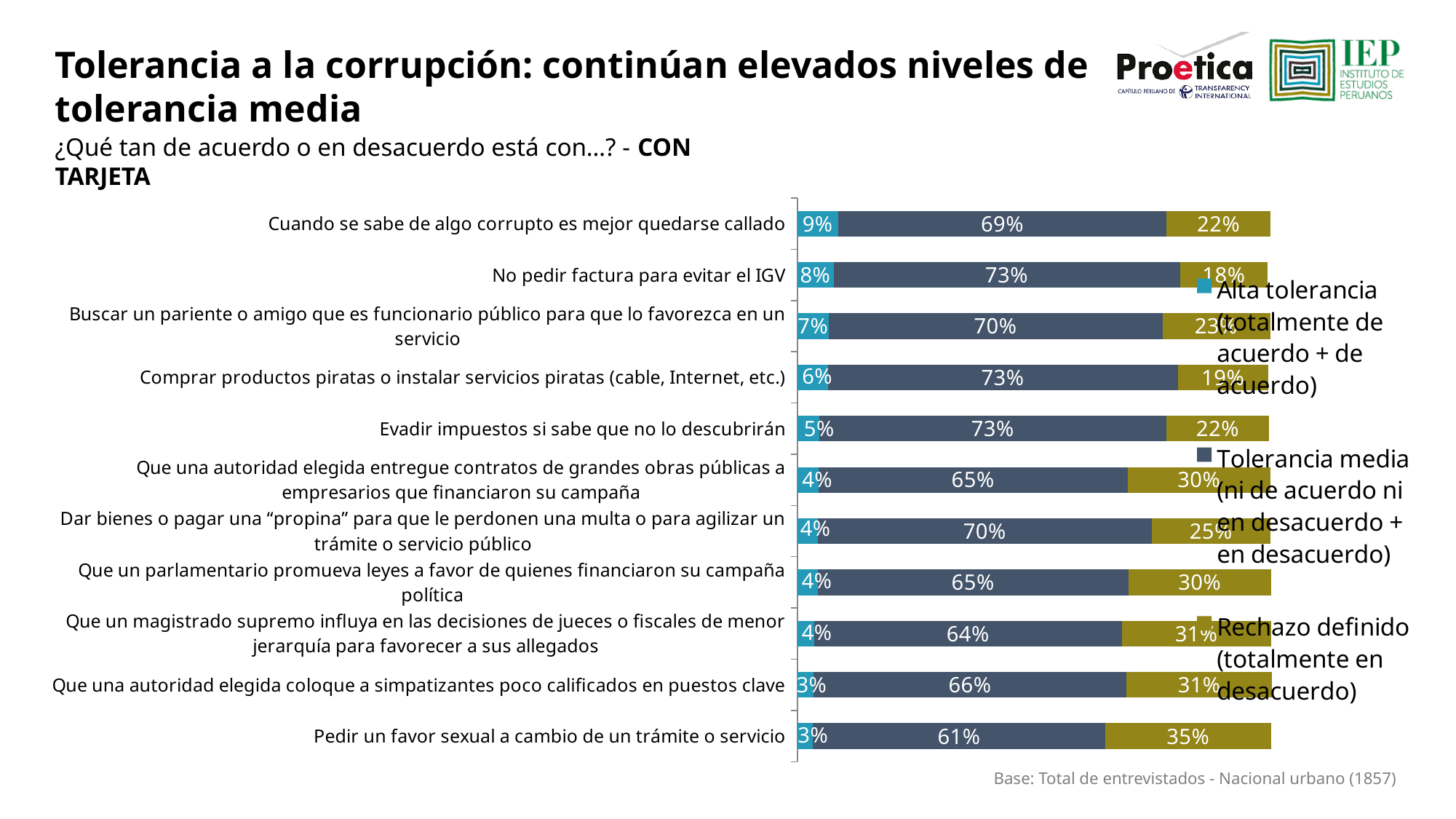
What is the total of the stacked bar for 'Cuando se sabe de algo corrupto es mejor quedarse callado'? 100% What is the 'Rechazo definido' value for 'Pedir un favor sexual a cambio de un trámite o servicio'? 35% What is the 'Alta tolerancia' value for 'Evadir impuestos si sabe que no lo descubrirán'? 5% What is the difference between the 'Rechazo definido' values for 'Pedir un favor sexual a cambio de un trámite o servicio' and 'No pedir factura para evitar el IGV'? 17% What is the 'Tolerancia media' value for 'No pedir factura para evitar el IGV'? 73% Which statement has the highest 'Rechazo definido' value? Pedir un favor sexual a cambio de un trámite o servicio Which is larger: the 'Tolerancia media' value for 'Comprar productos piratas o instalar servicios piratas (cable, Internet, etc.)' or for 'Que un magistrado supremo influya en las decisiones de jueces o fiscales de menor jerarquía para favorecer a sus allegados'? Comprar productos piratas o instalar servicios piratas (cable, Internet, etc.) What kind of chart is shown on the slide? Stacked bar chart Which statement has the lowest 'Tolerancia media' value? Pedir un favor sexual a cambio de un trámite o servicio Which statement has the highest 'Alta tolerancia' value? Cuando se sabe de algo corrupto es mejor quedarse callado How many series does the legend list? 3 How many statements (categories) are plotted in the chart? 11